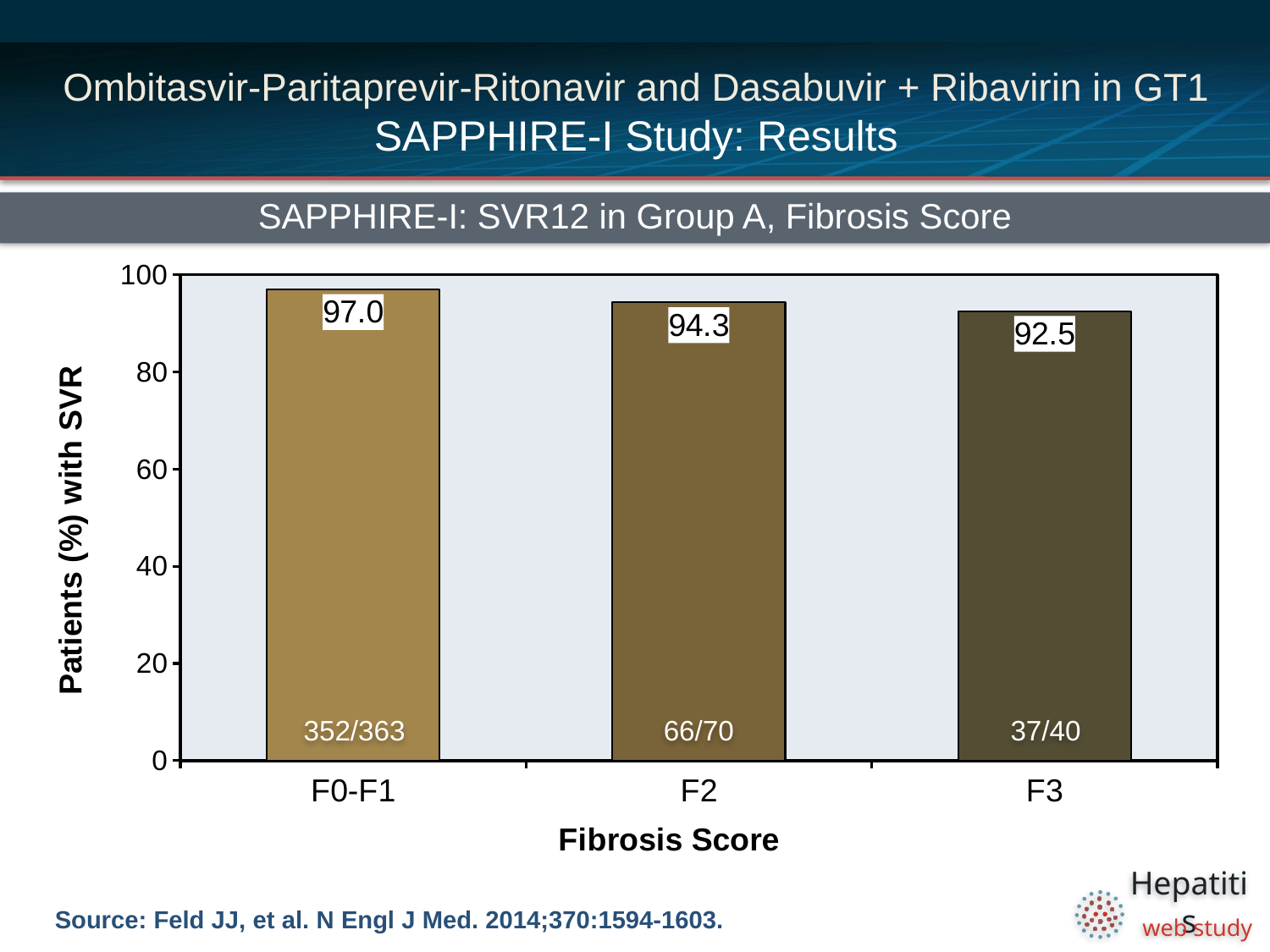
What is the SVR12 rate for the F2 fibrosis score group? 94.3 Which fibrosis score group has the highest SVR12 rate? F0-F1 What fraction of patients (n/N) is shown for the F0-F1 group? 352/363 What is the SVR12 rate for the F0-F1 fibrosis score group? 97.0 How many fibrosis score categories are shown on the x axis? 3 What is the label of the y axis? Patients (%) with SVR What is the SVR12 rate for the F3 fibrosis score group? 92.5 What fraction of patients (n/N) is shown for the F2 group? 66/70 Which group has a higher SVR12 rate, F2 or F3? F2 What kind of chart is shown on the slide? Bar chart What is the difference in SVR12 rate between the F0-F1 and F3 groups? 4.5 Which fibrosis score group has the lowest SVR12 rate? F3